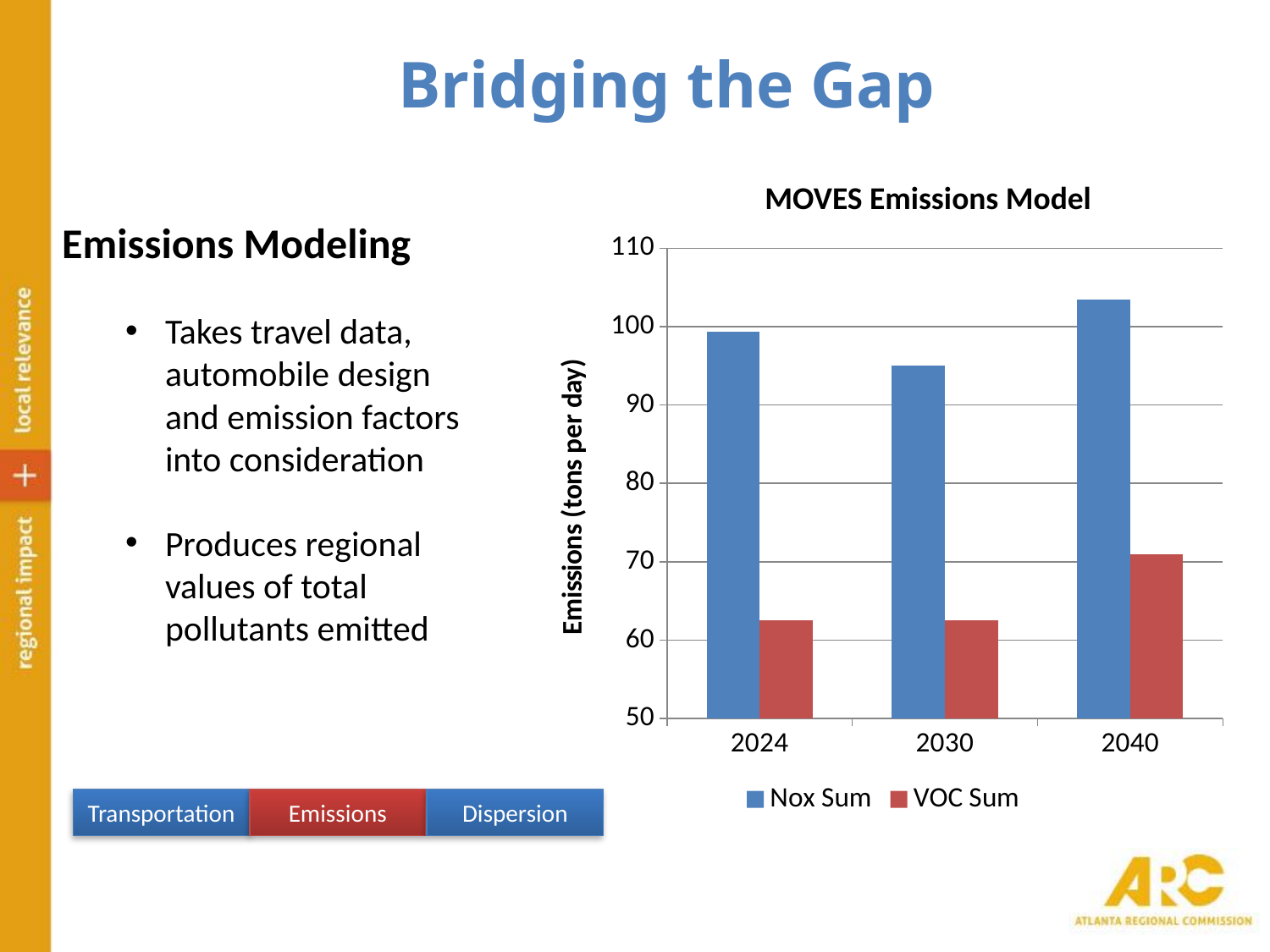
Is the VOC Sum value for 2040 greater or less than 70? greater What kind of chart is shown on the slide? bar chart How many series does the chart legend list? 2 Which year has the highest VOC Sum value? 2040 Which year has the lowest Nox Sum value? 2030 Which is larger in 2024, the Nox Sum or the VOC Sum? Nox Sum What is the title of the chart? MOVES Emissions Model Which year has the highest Nox Sum value? 2040 Is the Nox Sum value for 2030 greater or less than 100? less Is the Nox Sum value for 2040 greater or less than 100? greater How many years are shown on the x axis of the chart? 3 What is the label on the y axis of the chart? Emissions (tons per day)